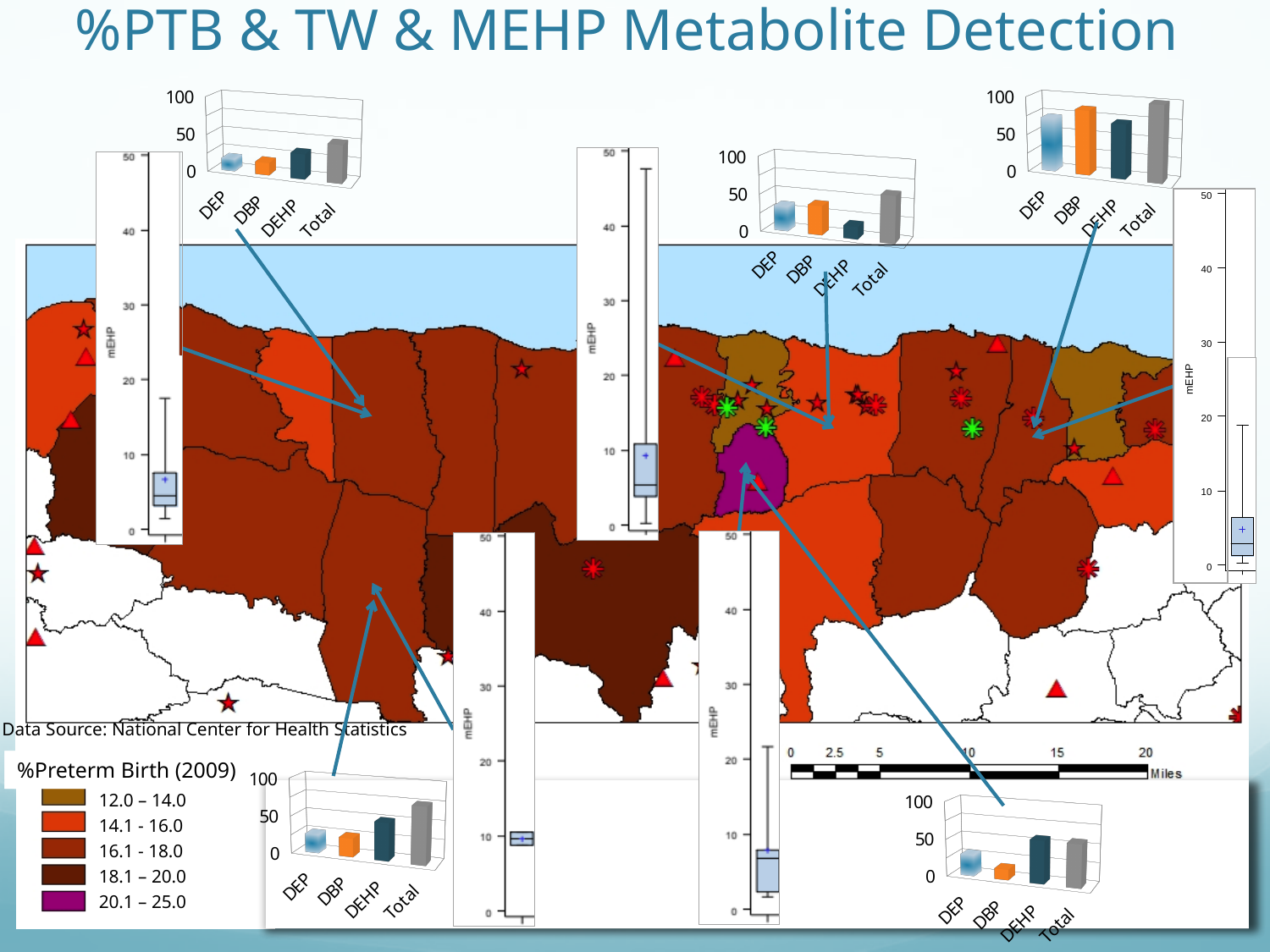
How many categories are shown on the x axis of the bar chart at the top left of the slide? 4 In the bar chart at the bottom right of the slide, which category has the shortest bar? DBP In the bar chart at the bottom left of the slide, which is larger, DEHP or DBP? DEHP In the bar chart at the top right of the slide, which category has the tallest bar? Total What is the label on the vertical axis of the box plots on the slide? mEHP In the bar chart at the top right of the slide, is the value for DEP greater or less than 50? greater What kind of chart is the chart at the top left of the slide with DEP, DBP, DEHP and Total on its axis? bar chart In the bar chart at the top center of the slide, is the value for Total greater or less than 50? greater In the bar chart at the top left of the slide, which category has the tallest bar? Total In the bar chart at the top center of the slide, which category has the shortest bar? DEHP In the bar chart at the top right of the slide, which is larger, DBP or DEP? DBP